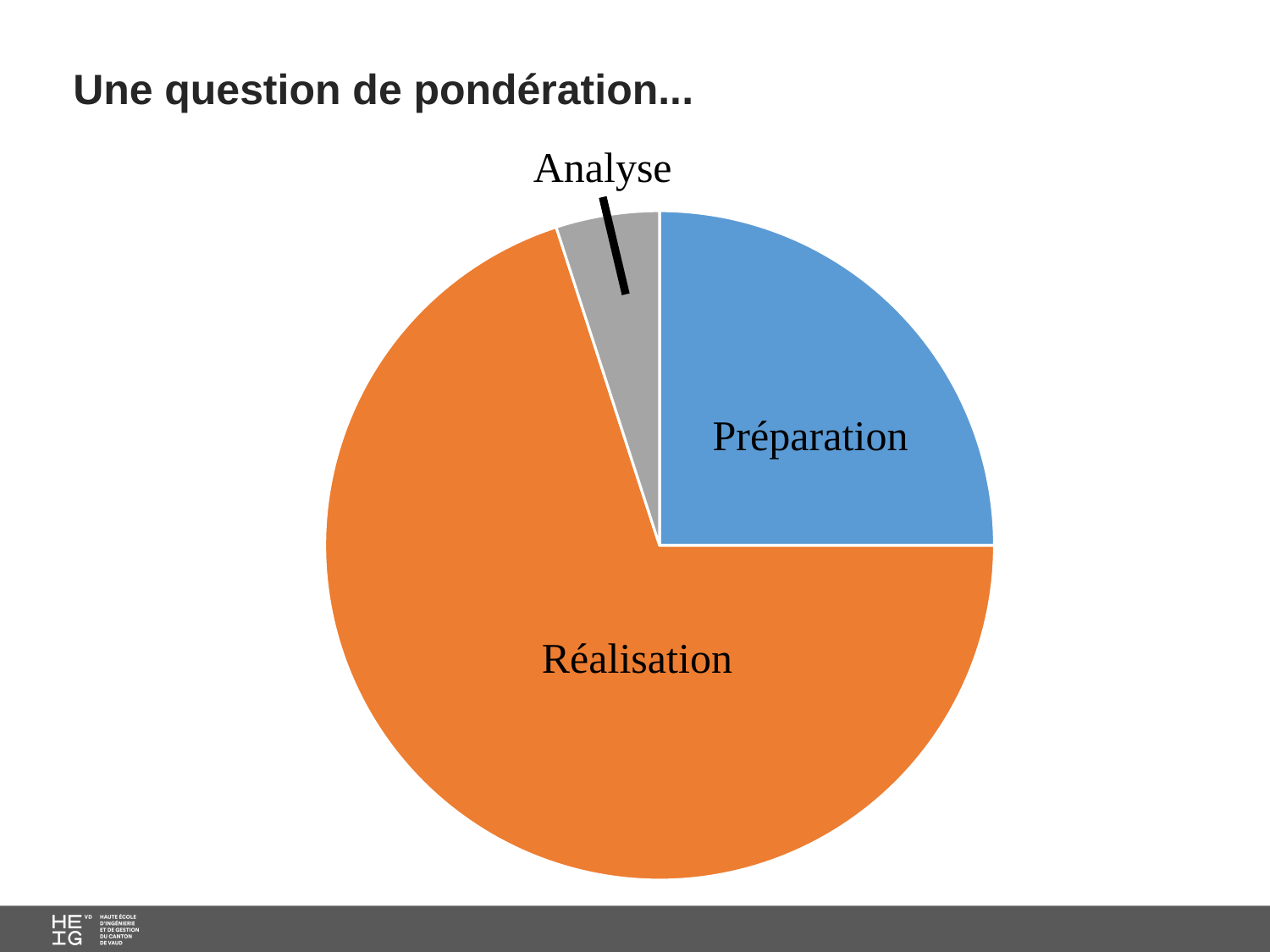
What kind of chart is shown on the slide? pie chart Which slice of the pie chart is the smallest? Analyse How many slices does the pie chart have? 3 What is the title of the slide containing the pie chart? Une question de pondération... Which slice is smaller, Analyse or Réalisation? Analyse What colour is the Réalisation slice? orange Which slice is larger, Préparation or Analyse? Préparation Which slice is larger, Réalisation or Préparation? Réalisation Which slice of the pie chart is the largest? Réalisation